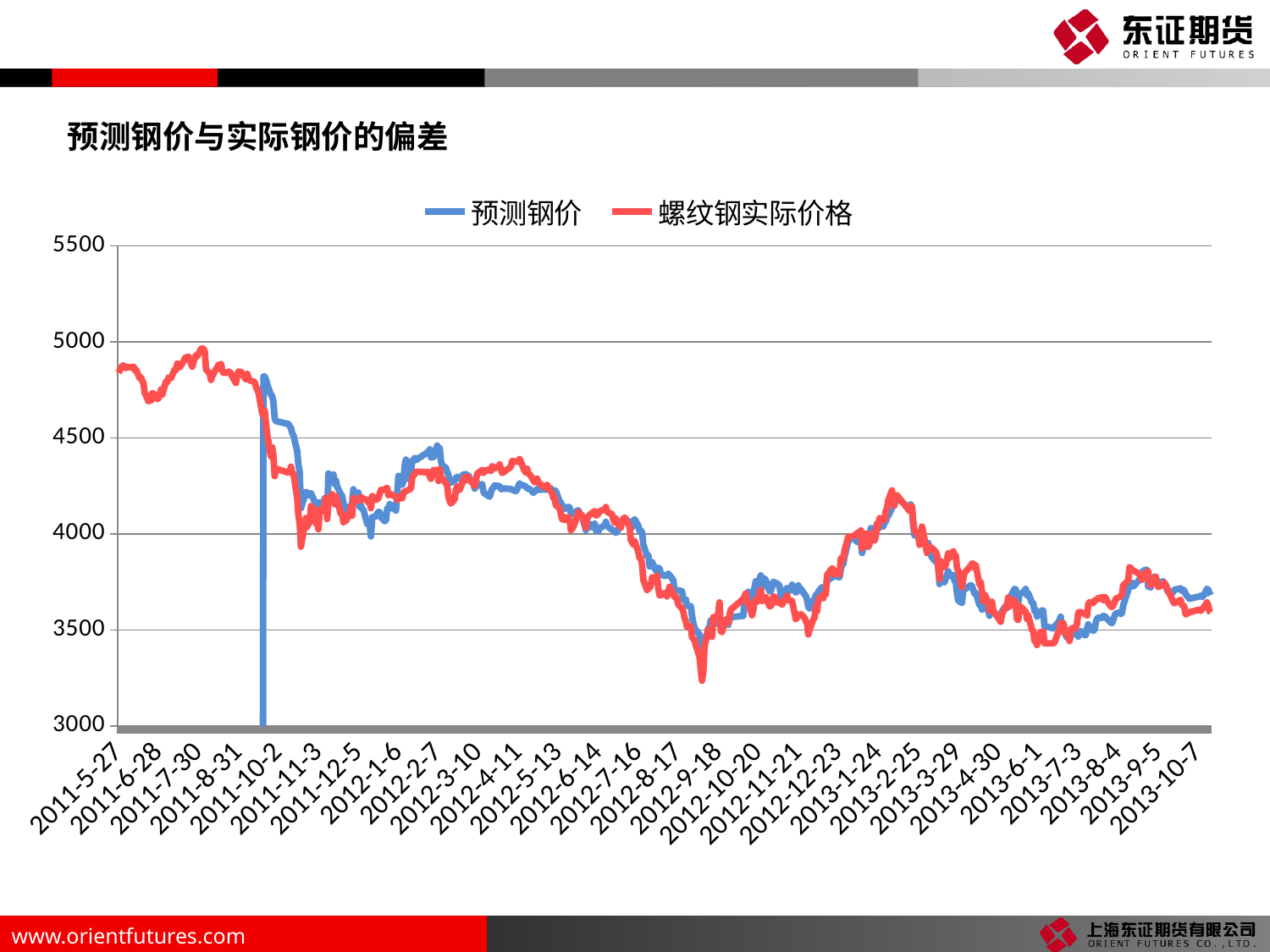
Which series is drawn in red? 螺纹钢实际价格 Is the value of 螺纹钢实际价格 at 2011-5-27 greater or less than 4500? greater Around which x-axis date does 螺纹钢实际价格 reach its lowest value? 2012-9-18 Does 预测钢价 rise or fall from 2012-12-23 to 2013-1-24? rise What kind of chart is shown on the slide? line chart What is the title of the chart? 预测钢价与实际钢价的偏差 How many series does the legend list? 2 Is the value of 螺纹钢实际价格 at 2011-7-30 greater or less than 4500? greater Is the value of 预测钢价 at 2013-10-7 greater or less than 3500? greater Does 螺纹钢实际价格 rise or fall overall from 2011-5-27 to 2013-10-7? fall